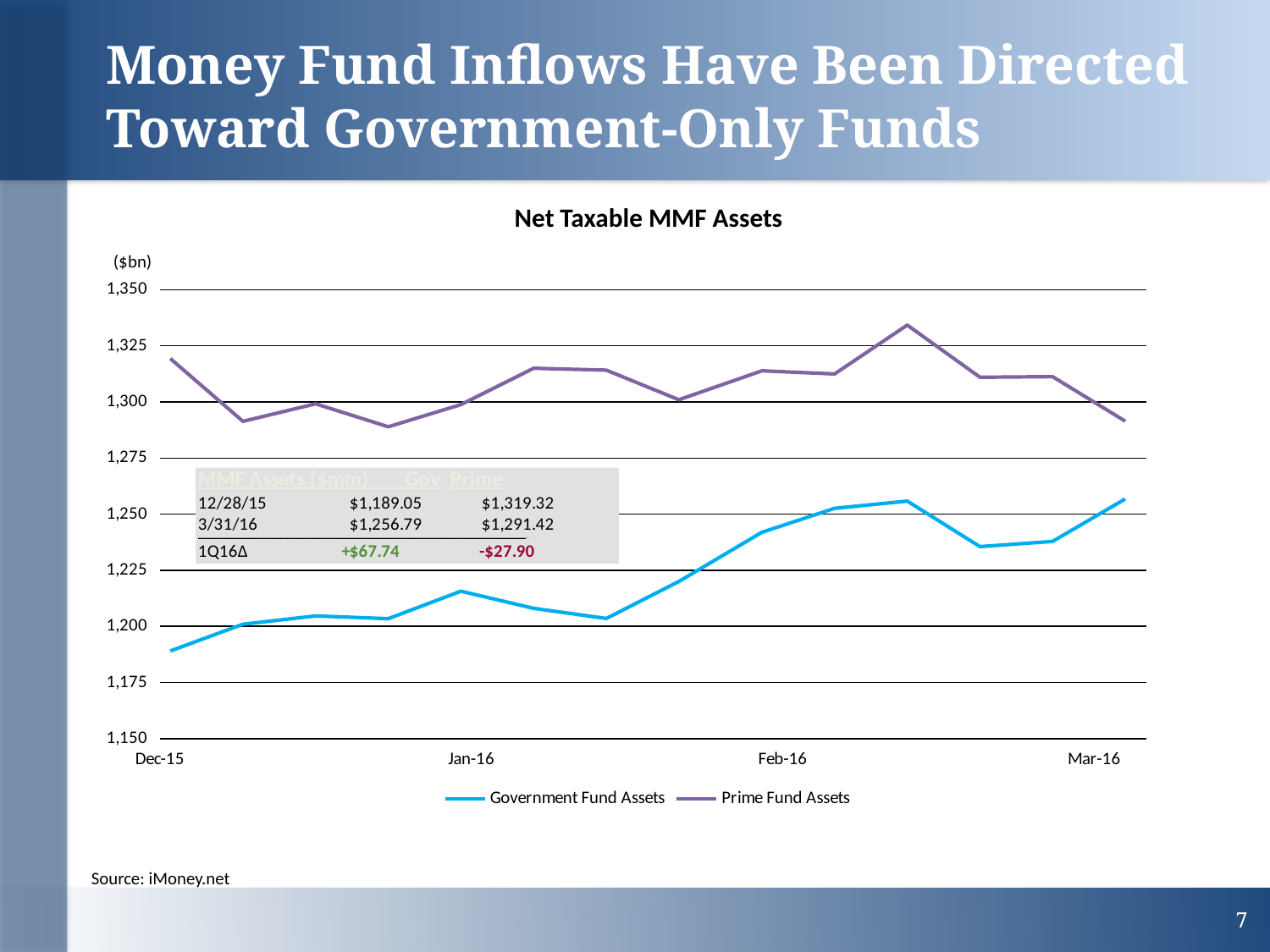
Do Government Fund Assets rise or fall from Dec-15 to Mar-16? rise What is the 1Q16 change in Government fund assets shown in the inset table? +$67.74 How many series does the legend list? 2 What is the title of the chart? Net Taxable MMF Assets Is the value for Government Fund Assets at Dec-15 greater or less than 1,200? less Do Prime Fund Assets rise or fall from Dec-15 to Mar-16? fall Which series is shown in purple? Prime Fund Assets According to the inset table, what were Government fund assets on 12/28/15? $1,189.05 What kind of chart is shown on the slide? line chart What is the 1Q16 change in Prime fund assets shown in the inset table? -$27.90 At Dec-15, which series is larger, Government Fund Assets or Prime Fund Assets? Prime Fund Assets According to the inset table, what were Prime fund assets on 3/31/16? $1,291.42